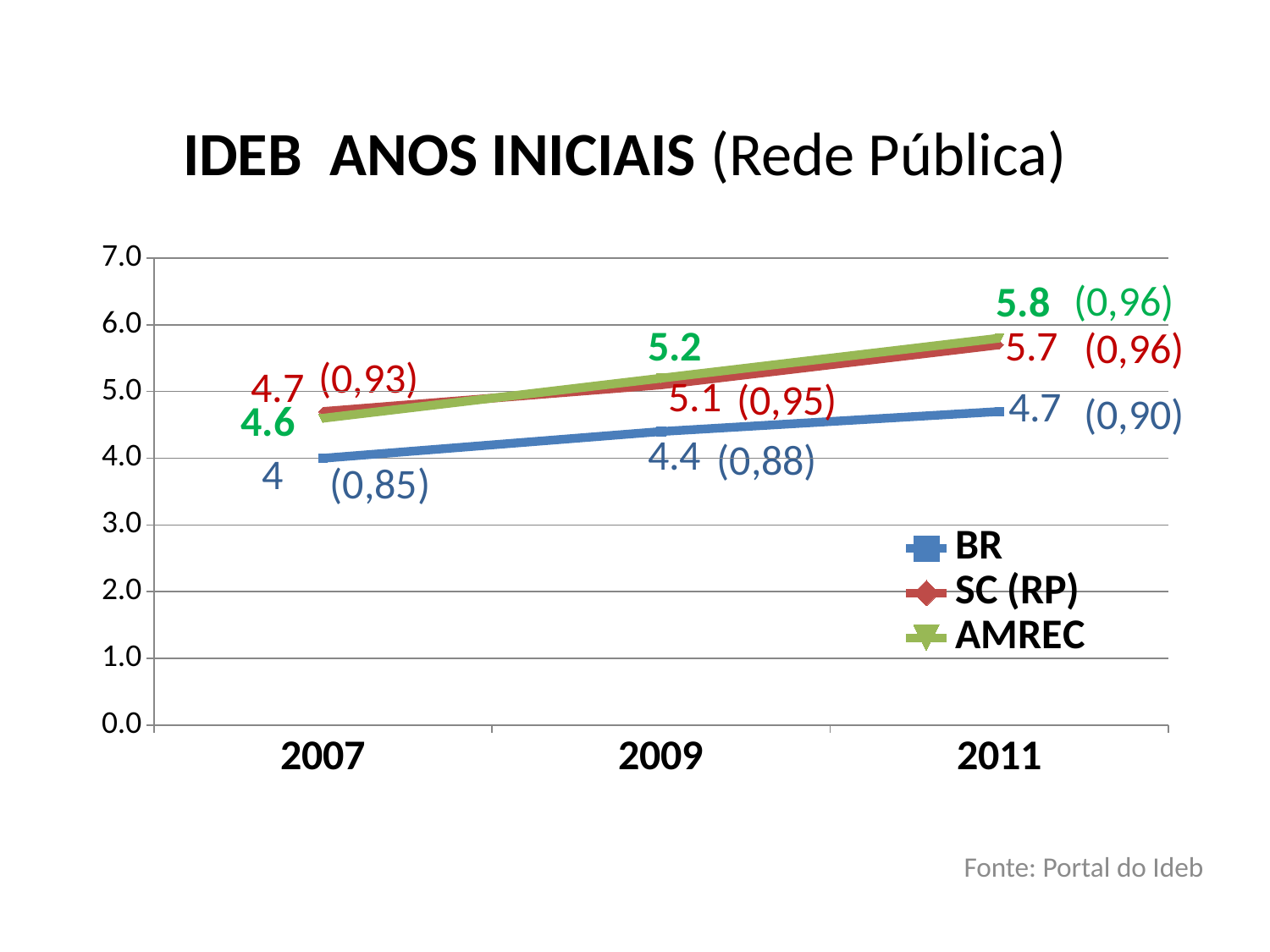
How many series does the legend list? 3 What is the difference between the SC (RP) value and the BR value in 2011? 1.0 Is the value for BR in 2009 greater or less than 5.0? less What is the value for BR in 2007? 4 What is the value for SC (RP) in 2009? 5.1 What is the difference between the AMREC value in 2011 and the AMREC value in 2007? 1.2 What is the value for BR in 2011? 4.7 Does the BR series rise or fall from 2007 to 2011? rise How many years are shown on the x axis? 3 In which year is the BR series lowest? 2007 What is the value for AMREC in 2011? 5.8 What type of chart is shown on the slide? line chart